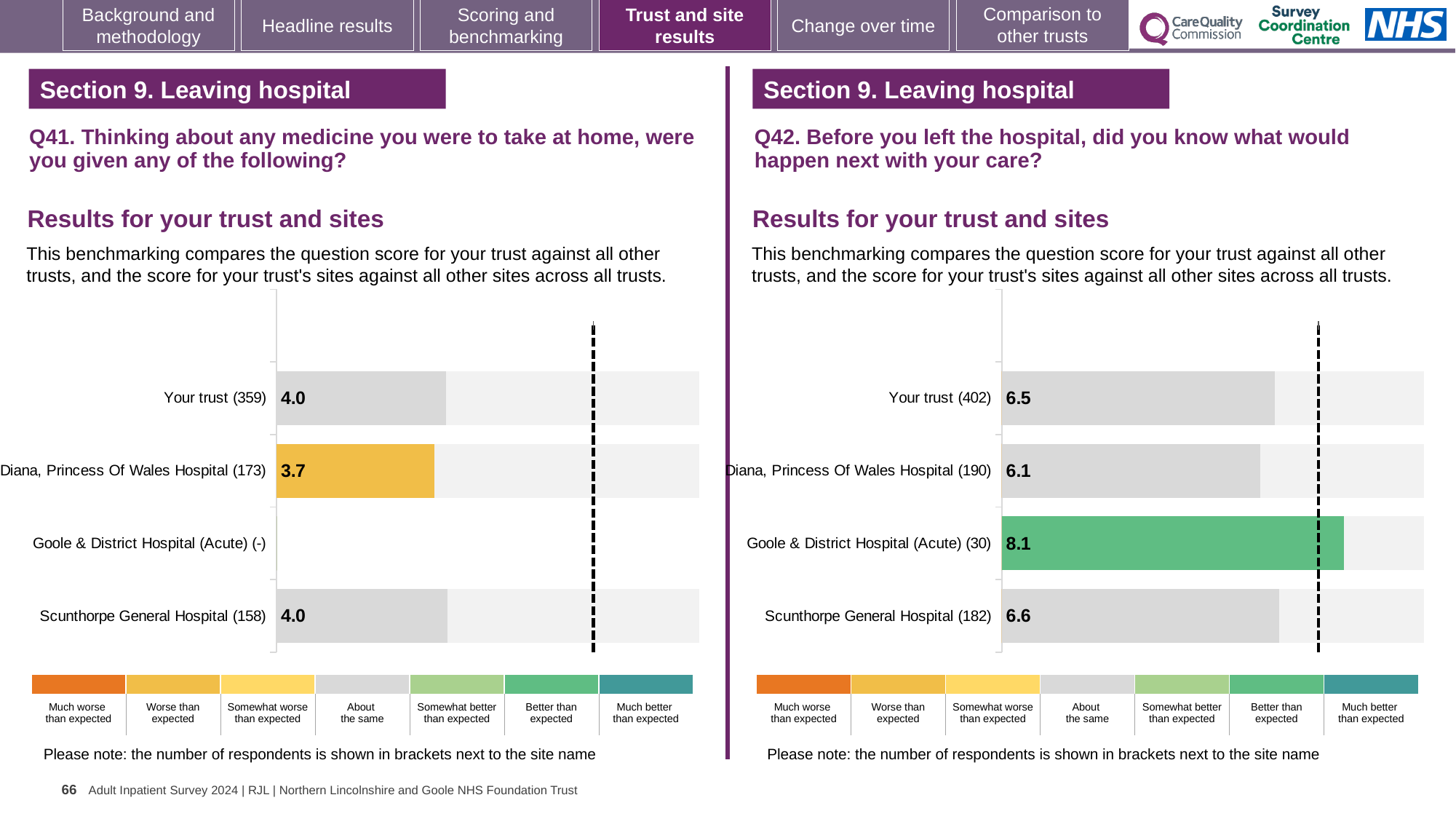
On the Q41 chart (left), what is the score for Diana, Princess Of Wales Hospital? 3.7 On the Q42 chart (right), what is the difference between the scores for Goole & District Hospital (Acute) and Diana, Princess Of Wales Hospital? 2.0 On the Q41 chart (left), what is the score for Your trust? 4.0 On the Q41 chart (left), which has the higher score: Your trust or Diana, Princess Of Wales Hospital? Your trust How many respondents are shown in brackets for Your trust on the Q42 chart (right)? 402 On the Q42 chart (right), what is the score for Scunthorpe General Hospital? 6.6 On the Q42 chart (right), which site has the lowest score? Diana, Princess Of Wales Hospital On the Q42 chart (right), how many sites (including Your trust) are listed? 4 On the Q42 chart (right), what is the difference between the scores for Your trust and Diana, Princess Of Wales Hospital? 0.4 On the Q42 chart (right), which site has the highest score? Goole & District Hospital (Acute) On the Q42 chart (right), what is the score for Goole & District Hospital (Acute)? 8.1 What kind of chart is used on the Q41 chart (left)? Bar chart